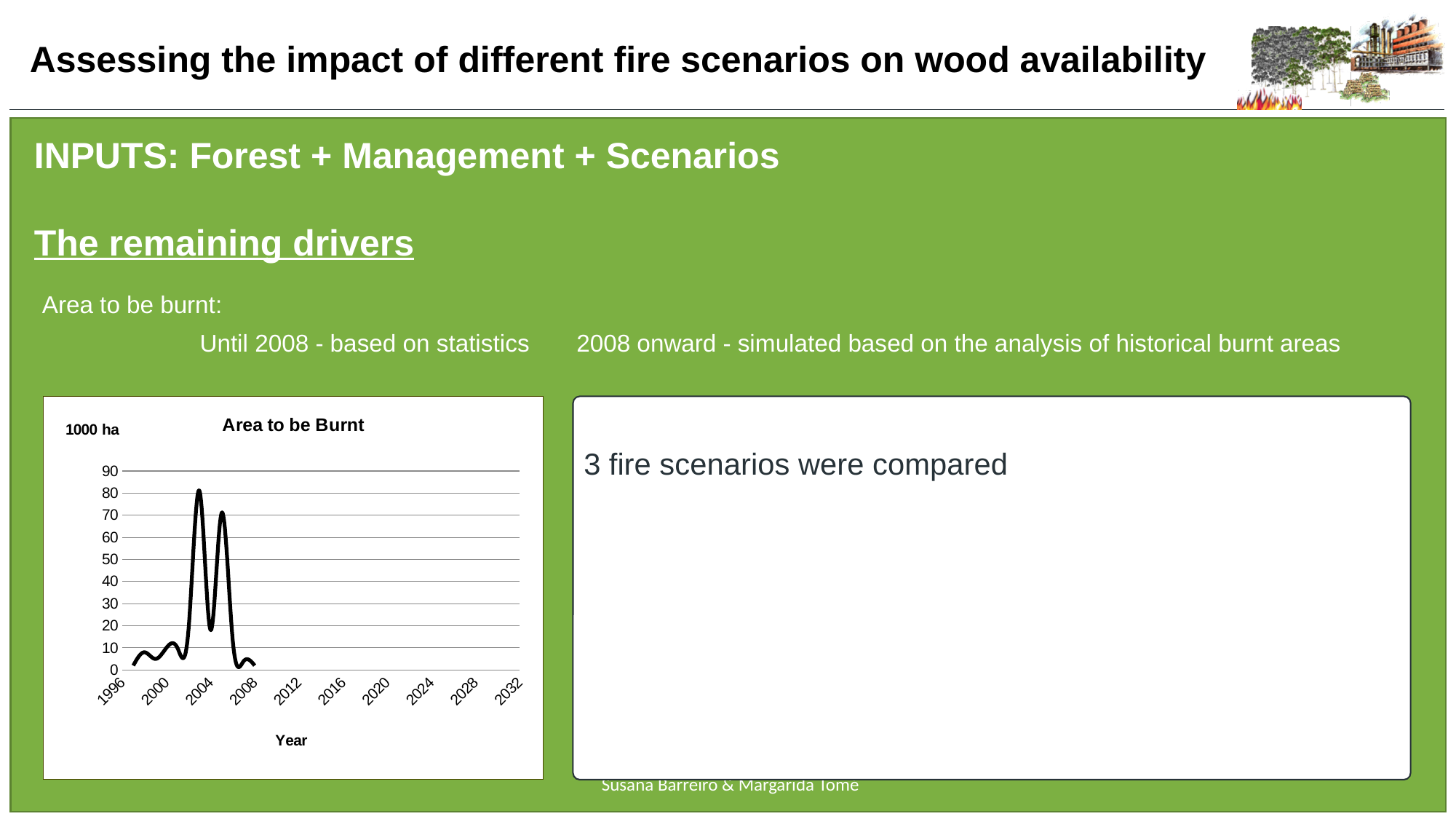
What is the highest value labelled on the vertical axis? 90 After the second peak, does the line rise or fall toward 2008? fall What unit is shown on the vertical axis of the chart? 1000 ha Is the second peak of the line greater or less than 60? greater What is the title of the chart? Area to be Burnt What kind of chart is shown on the slide? line chart Is the highest value reached by the line greater or less than 70? greater Is the value at the dip between the two peaks greater or less than 30? less How many year labels are shown on the horizontal axis? 10